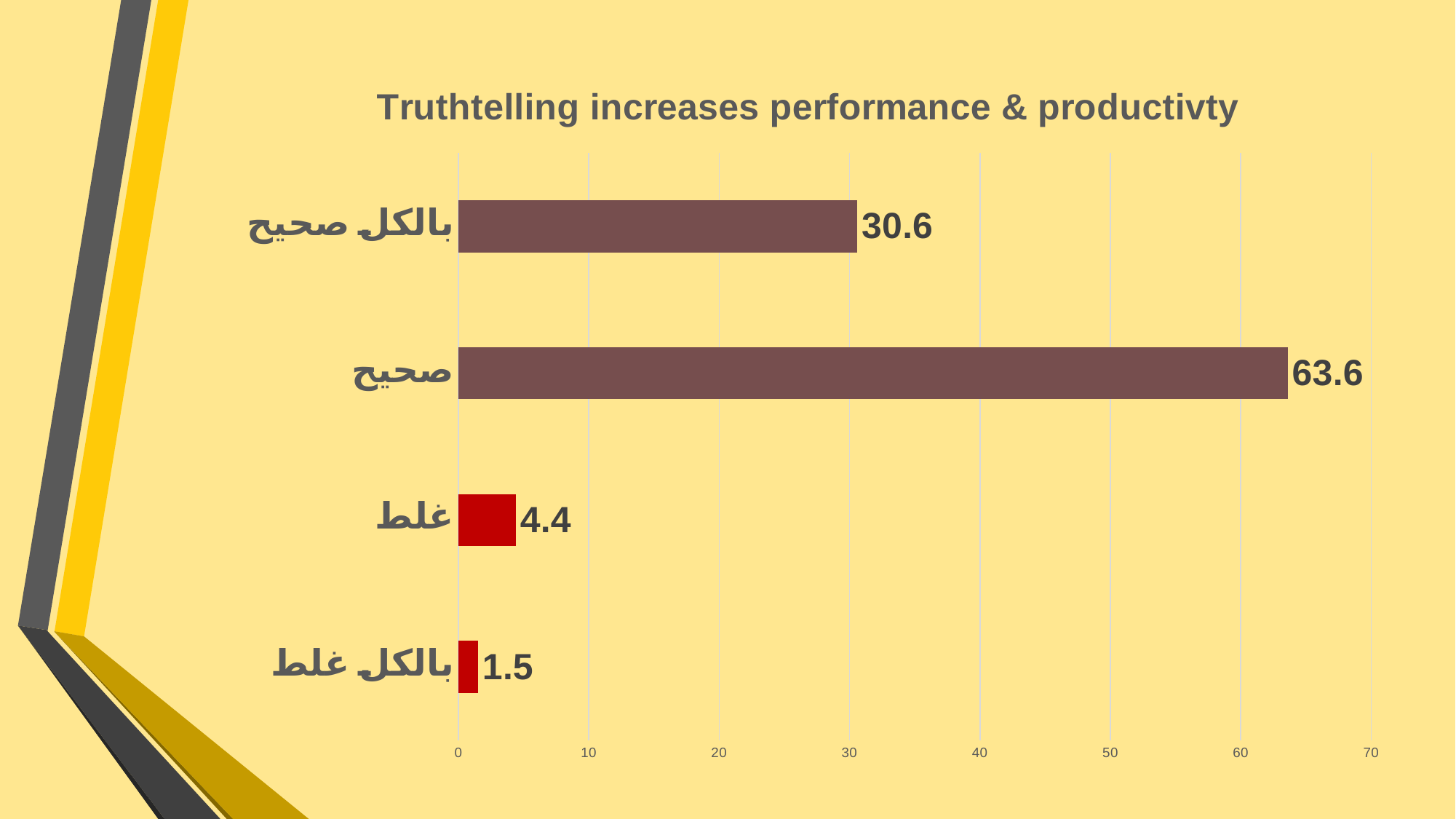
How many categories are shown in the chart? 4 What is the value for صحيح? 63.6 Which category has the highest value? صحيح What kind of chart is shown on the slide? bar chart Which is larger, the value for غلط or the value for بالكل غلط? غلط Is the value for صحيح greater or less than 60? greater What is the value for بالكل غلط? 1.5 What is the value for بالكل صحيح? 30.6 What is the title of the chart? Truthtelling increases performance & productivty What is the difference between the values for صحيح and بالكل صحيح? 33 Which category has the lowest value? بالكل غلط What is the value for غلط? 4.4